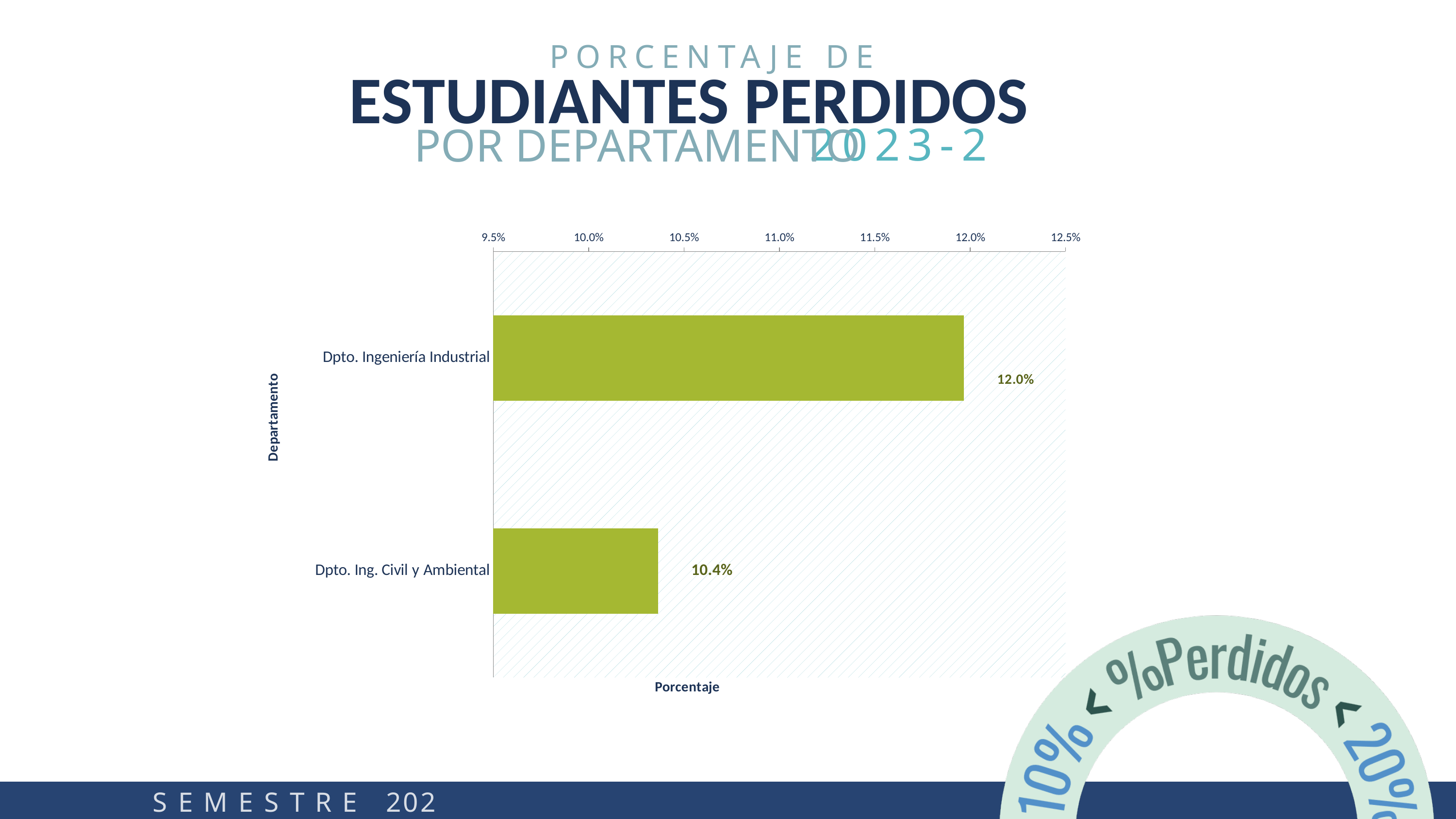
What is the label of the vertical axis? Departamento What is the label of the horizontal axis? Porcentaje What kind of chart is shown on the slide? bar chart Is the value for Dpto. Ingeniería Industrial greater or less than 11.5%? greater What is the value for Dpto. Ing. Civil y Ambiental? 10.4% Is the value for Dpto. Ing. Civil y Ambiental greater or less than 11.0%? less Which department has the lowest percentage? Dpto. Ing. Civil y Ambiental Which is larger, the value for Dpto. Ingeniería Industrial or the value for Dpto. Ing. Civil y Ambiental? Dpto. Ingeniería Industrial How many departments are shown in the chart? 2 What is the difference between the values for Dpto. Ingeniería Industrial and Dpto. Ing. Civil y Ambiental? 1.6% What is the value for Dpto. Ingeniería Industrial? 12.0% Which department has the highest percentage? Dpto. Ingeniería Industrial